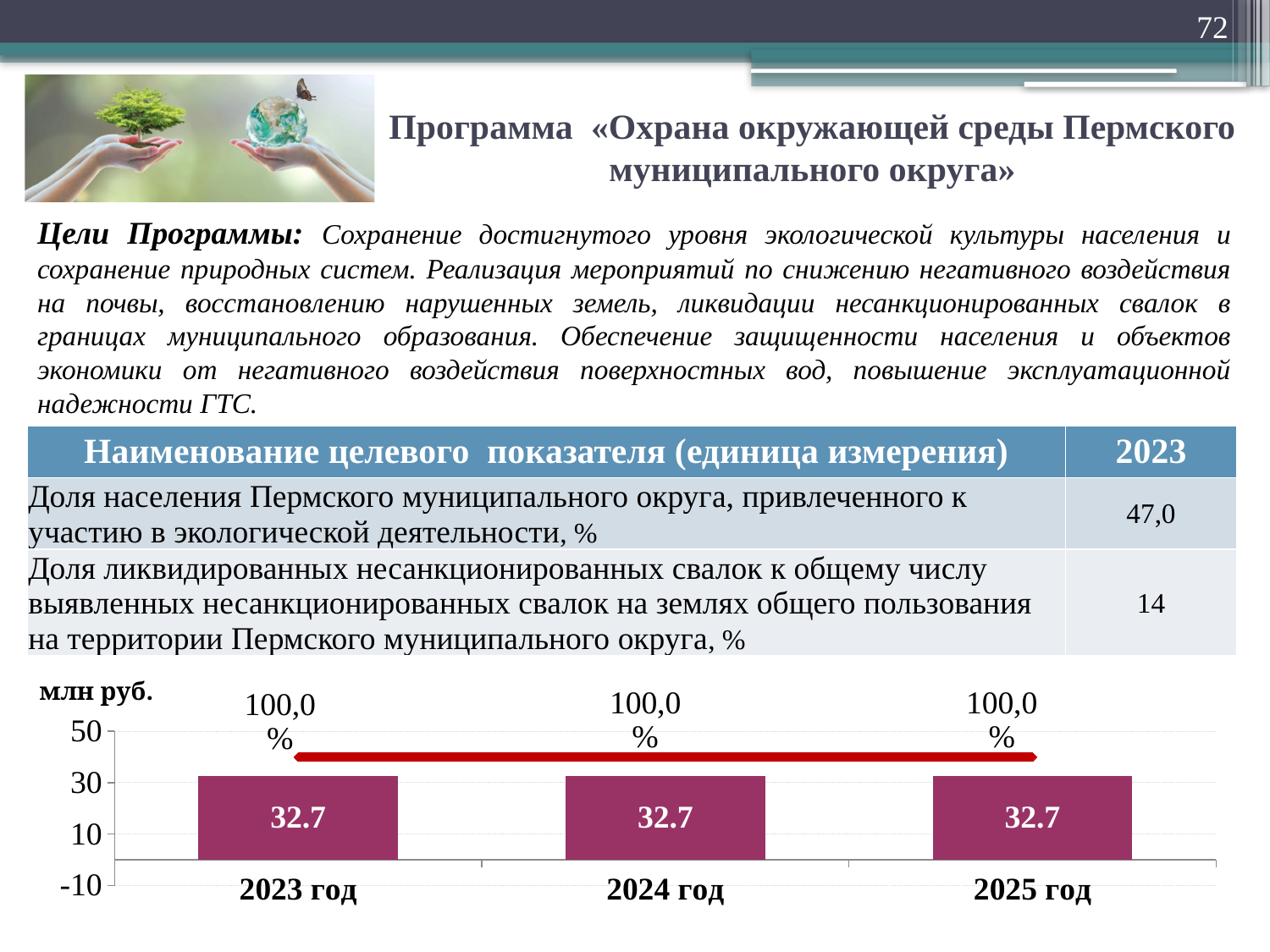
What is the value for 2023 год in the bar chart? 32.7 What unit is indicated above the y axis of the bar chart? млн руб. What kind of chart is shown at the bottom of the slide? combination bar and line chart Is the value for 2025 год in the bar chart greater or less than 30? greater What percentage label is shown above each bar along the red line in the chart? 100,0 % Do the bar values rise, fall or stay the same from 2023 год to 2025 год? stay the same What is the value for 2024 год in the bar chart? 32.7 What is the difference between the values for 2024 год and 2023 год in the bar chart? 0.0 Is the value for 2023 год in the bar chart greater or less than 50? less What is the value for 2025 год in the bar chart? 32.7 How many categories (years) are shown on the x axis of the bar chart? 3